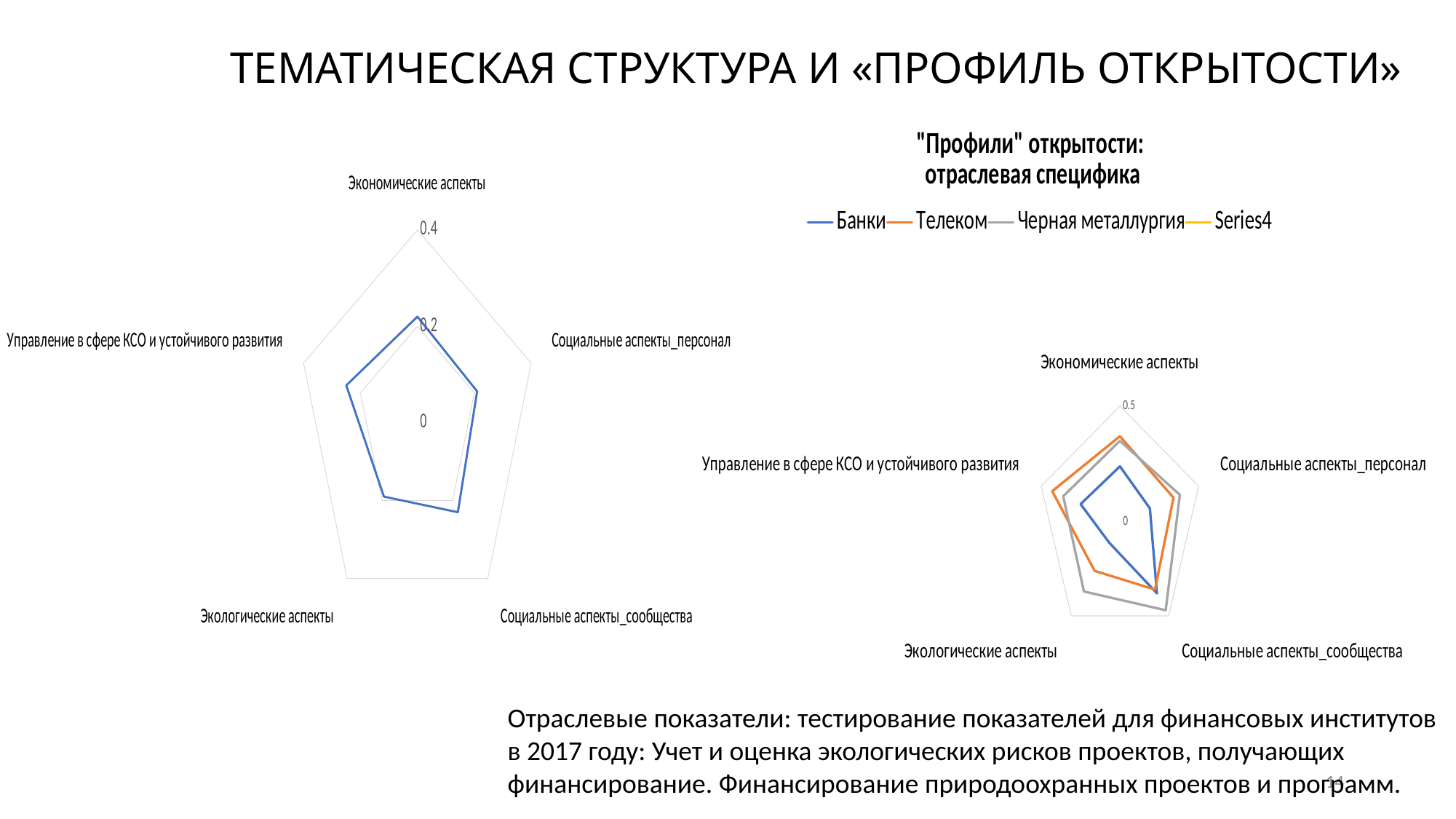
What kind of chart is the chart titled "Профили" открытости: отраслевая специфика? Radar chart In the chart titled "Профили" открытости: отраслевая специфика, which series has the highest value for Социальные аспекты_сообщества? Черная металлургия In the chart titled "Профили" открытости: отраслевая специфика, which series has the highest value for Экономические аспекты? Телеком What kind of chart is the chart on the left side of the slide? Radar chart What is the title of the chart on the right side of the slide? "Профили" открытости: отраслевая специфика In the chart titled "Профили" открытости: отраслевая специфика, which is larger for Экономические аспекты: Банки or Телеком? Телеком In the chart titled "Профили" открытости: отраслевая специфика, what colour is the line for Телеком? Orange In the chart on the left side of the slide, is the value for Экономические аспекты greater or less than 0.4? less How many categories (axes) does the chart on the left side of the slide have? 5 In the chart titled "Профили" открытости: отраслевая специфика, which series has the lowest value for Социальные аспекты_сообщества? Телеком How many series does the legend of the chart titled "Профили" открытости: отраслевая специфика list? 4 In the chart titled "Профили" открытости: отраслевая специфика, is the value of Телеком for Экономические аспекты greater or less than 0.5? less